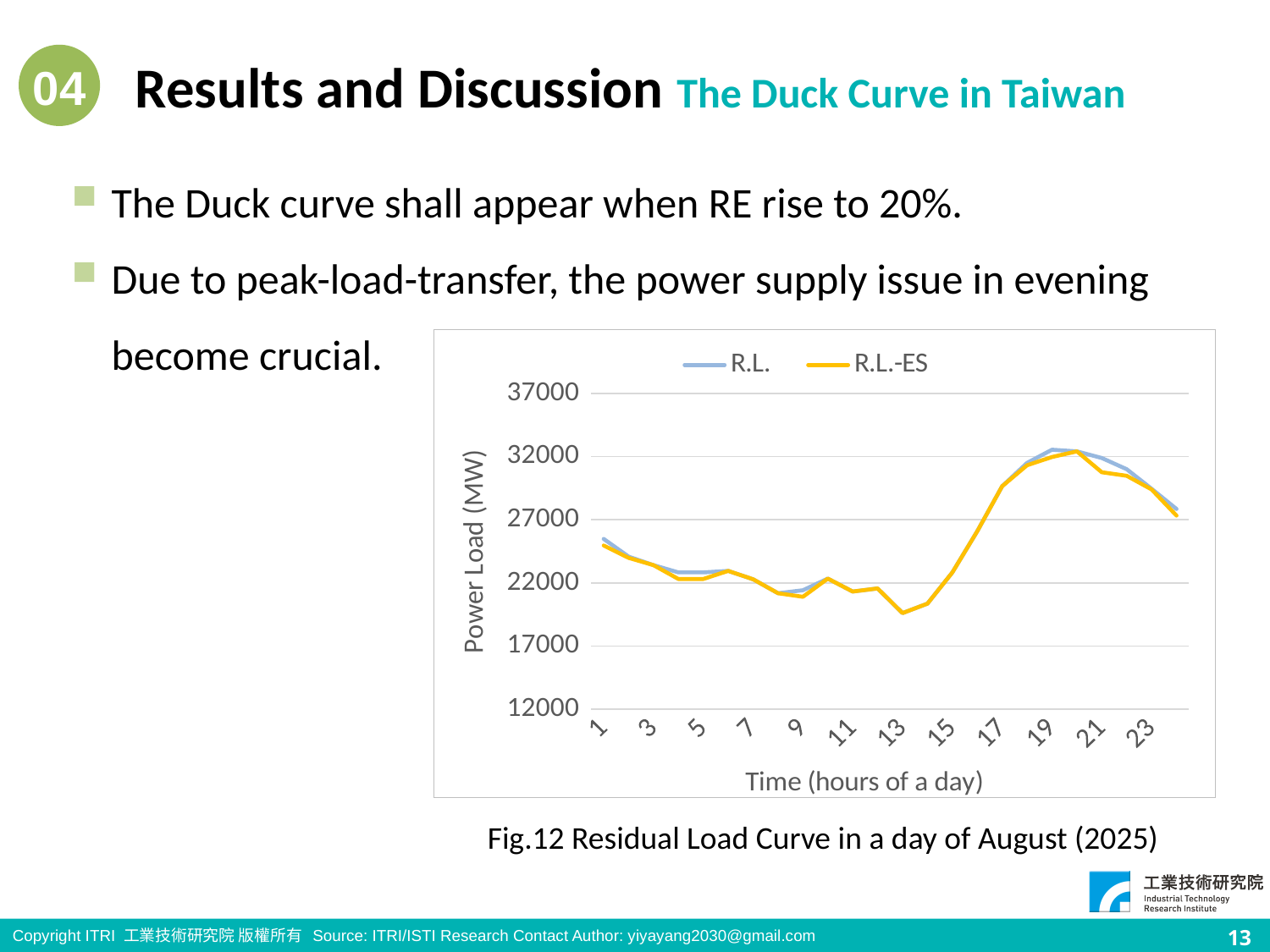
Is the R.L. value at hour 1 greater or less than 22000? greater Is the R.L. value at hour 17 greater or less than 27000? greater What kind of chart is shown on the slide? line chart What is the label of the vertical axis of the chart? Power Load (MW) What are the two series named in the chart legend? R.L. and R.L.-ES Do the values of the R.L. series rise or fall between hour 13 and hour 19? rise At hour 1, which series has the larger value, R.L. or R.L.-ES? R.L. Is the R.L. value at hour 1 greater or less than 27000? less Do the values of the R.L.-ES series rise or fall between hour 19 and hour 23? fall How many series does the chart legend list? 2